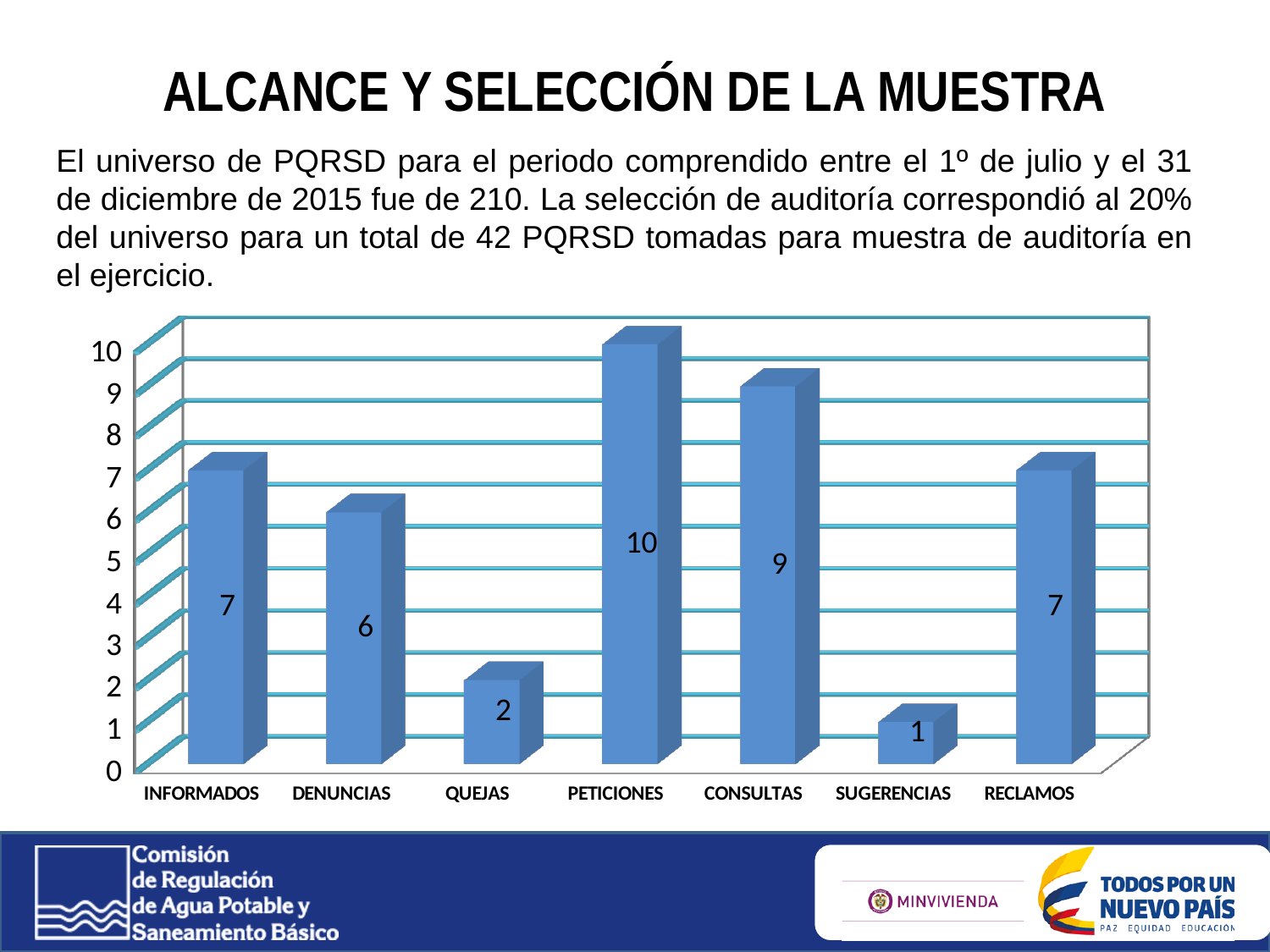
What is the value for CONSULTAS? 9 What is the difference between the values for PETICIONES and DENUNCIAS? 4 Which category has the highest value? PETICIONES How many categories are shown on the x axis? 7 What is the value for QUEJAS? 2 What kind of chart is shown on the slide? bar chart What is the value for PETICIONES? 10 Which is larger, the value for CONSULTAS or the value for RECLAMOS? CONSULTAS What colour are the bars in the chart? blue What is the total of all the bar values in the chart? 42 Which category has the lowest value? SUGERENCIAS What is the value for SUGERENCIAS? 1